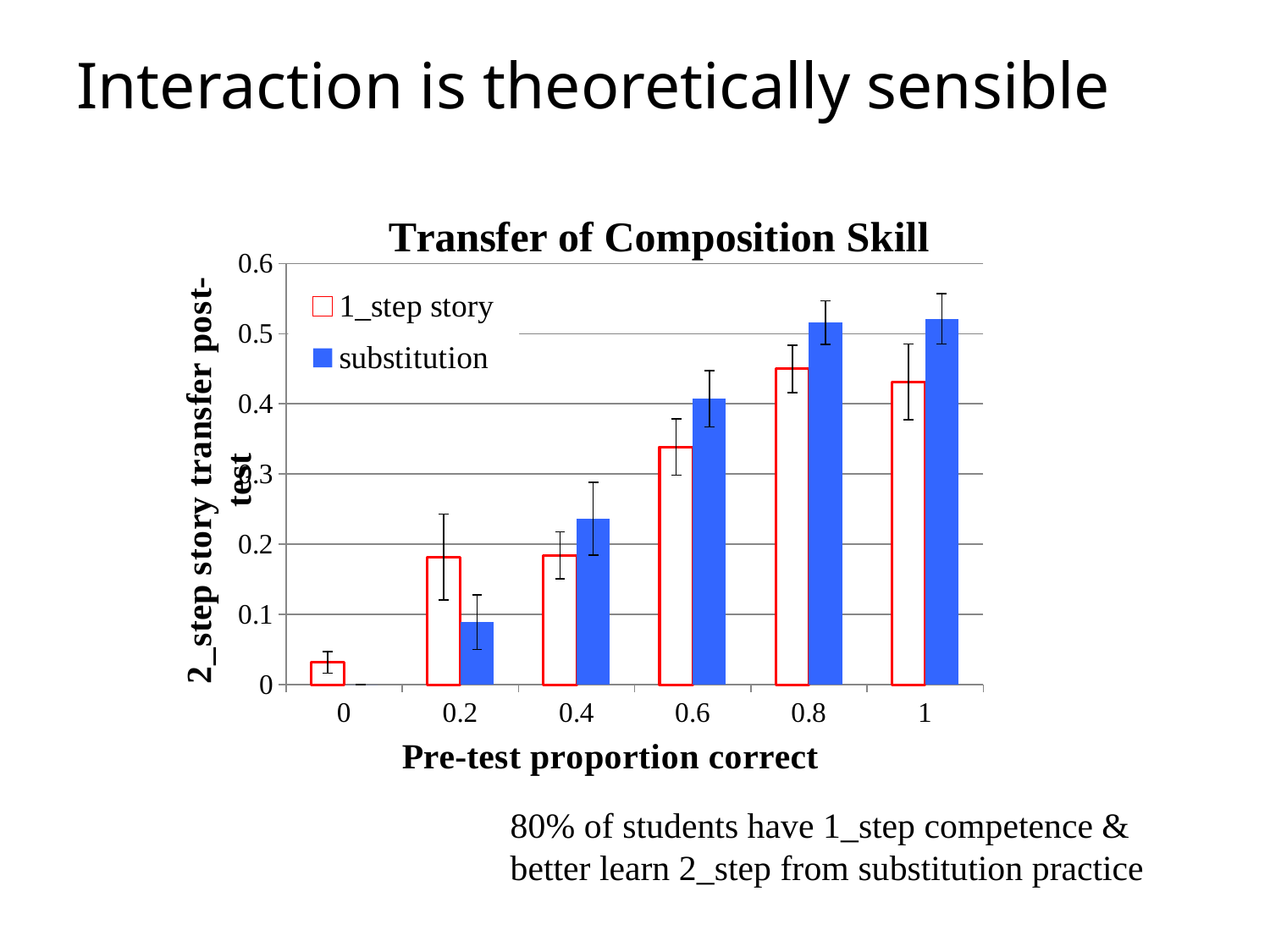
For which pre-test proportion correct category is the 1_step story value lowest? 0 Which series is drawn with solid blue bars? substitution At a pre-test proportion correct of 0.2, which series has the larger value, 1_step story or substitution? 1_step story What is the title of the chart? Transfer of Composition Skill Do the substitution values generally rise or fall as pre-test proportion correct increases? rise At a pre-test proportion correct of 0.8, which series has the larger value, 1_step story or substitution? substitution Is the substitution value at a pre-test proportion correct of 0.4 greater or less than 0.2? greater What kind of chart is shown on the slide? bar chart Is the 1_step story value at a pre-test proportion correct of 0.6 greater or less than 0.3? greater How many series does the chart's legend list? 2 How many pre-test proportion correct categories are shown on the x axis? 6 Is the 1_step story value at a pre-test proportion correct of 0.8 greater or less than 0.5? less